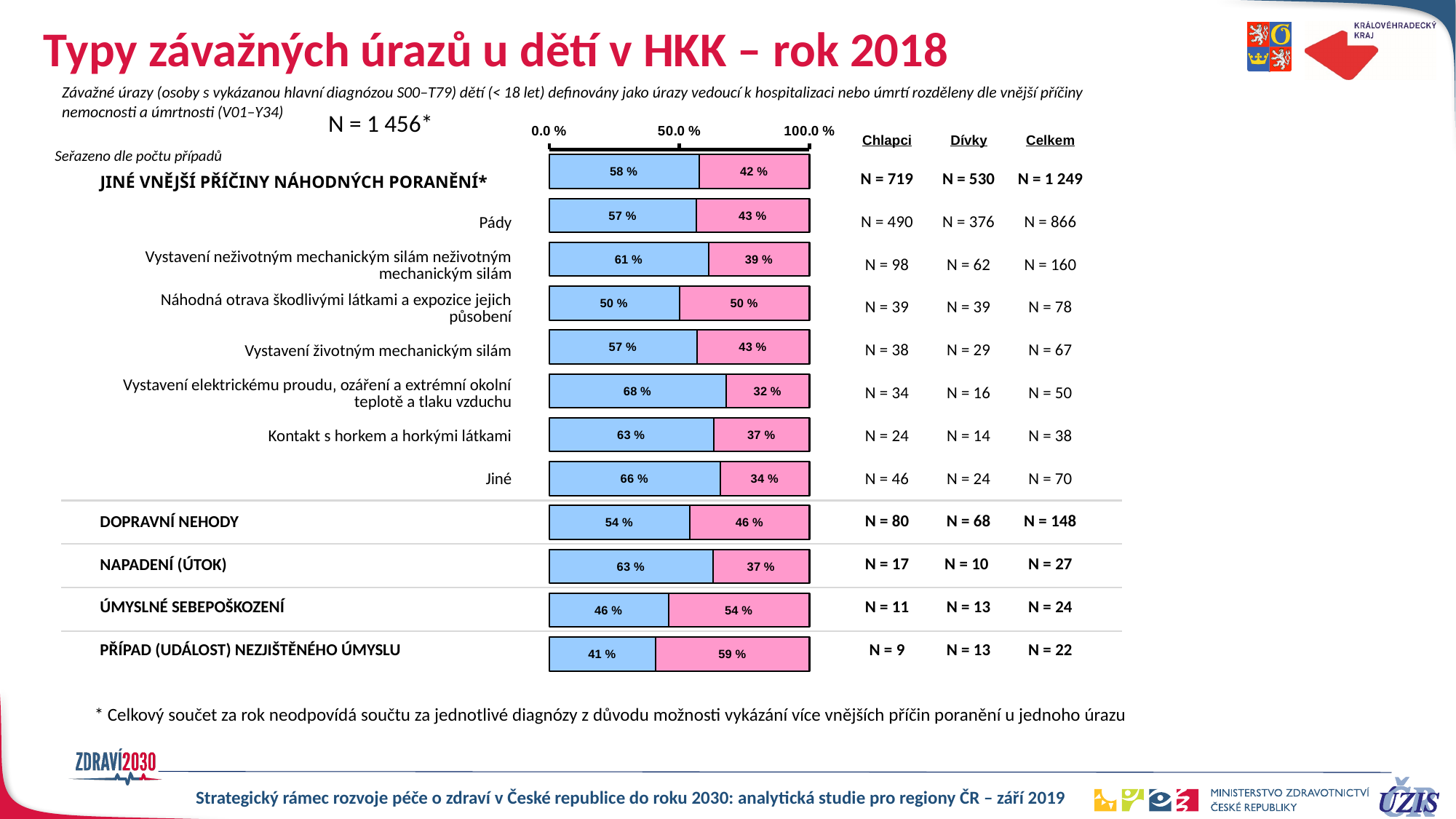
What percentage of the 'Pády' bar is for Chlapci (boys)? 57 % For 'Kontakt s horkem a horkými látkami', which group has the larger share, Chlapci or Dívky? Chlapci How many injury-type categories (bars) are shown in the chart? 12 Which injury type has the highest Chlapci (boys) share? Vystavení elektrickému proudu, ozáření a extrémní okolní teplotě a tlaku vzduchu (68 %) Which injury type has the highest Dívky (girls) share? PŘÍPAD (UDÁLOST) NEZJIŠTĚNÉHO ÚMYSLU (59 %) What are the Chlapci and Dívky shares for 'Náhodná otrava škodlivými látkami a expozice jejich působení'? 50 % and 50 % Which injury type has the lowest Chlapci (boys) share? PŘÍPAD (UDÁLOST) NEZJIŠTĚNÉHO ÚMYSLU (41 %) Which colour represents Chlapci (boys) in the bars? Blue What kind of chart is shown on the slide? Stacked horizontal bar chart What is the Dívky share for 'NAPADENÍ (ÚTOK)'? 37 % For 'Jiné', what is the difference between the Chlapci share and the Dívky share? 32 percentage points What percentage of the 'DOPRAVNÍ NEHODY' bar is for Dívky (girls)? 46 %